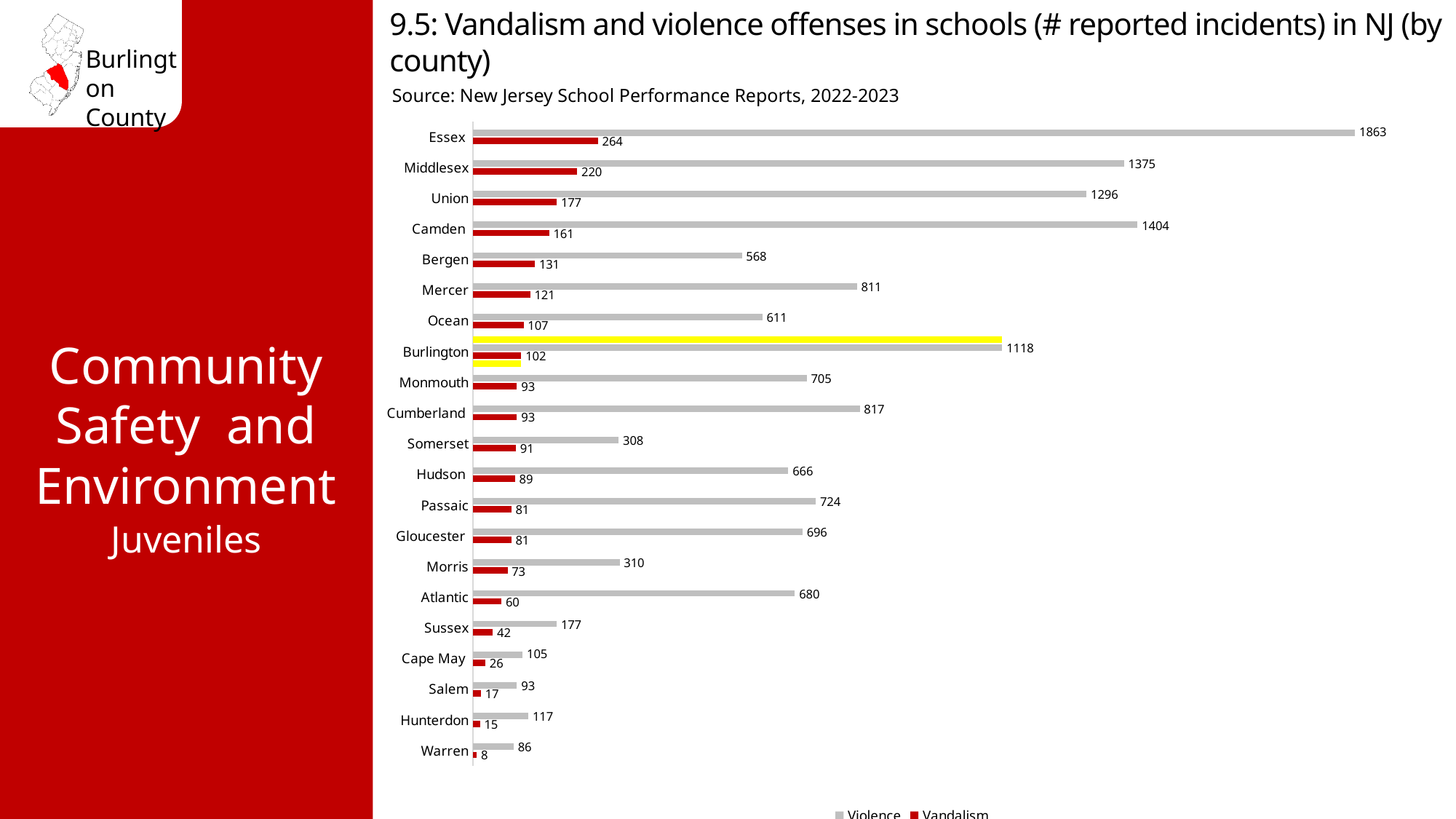
What is the difference between the violence values for Essex and Middlesex? 488 What is the number of reported vandalism incidents in Burlington County? 102 What is the number of reported violence incidents in Burlington County? 1118 What is the difference between the vandalism values for Burlington and Monmouth? 9 Which county has the highest number of reported violence incidents? Essex How many series does the legend list? 2 Which county has the lowest number of reported vandalism incidents? Warren What type of chart is shown on the slide? Bar chart Which county has a higher vandalism value, Union or Camden? Union Which county has a higher violence value, Cumberland or Mercer? Cumberland How many counties are shown in the chart? 21 What is the violence value for Camden? 1404